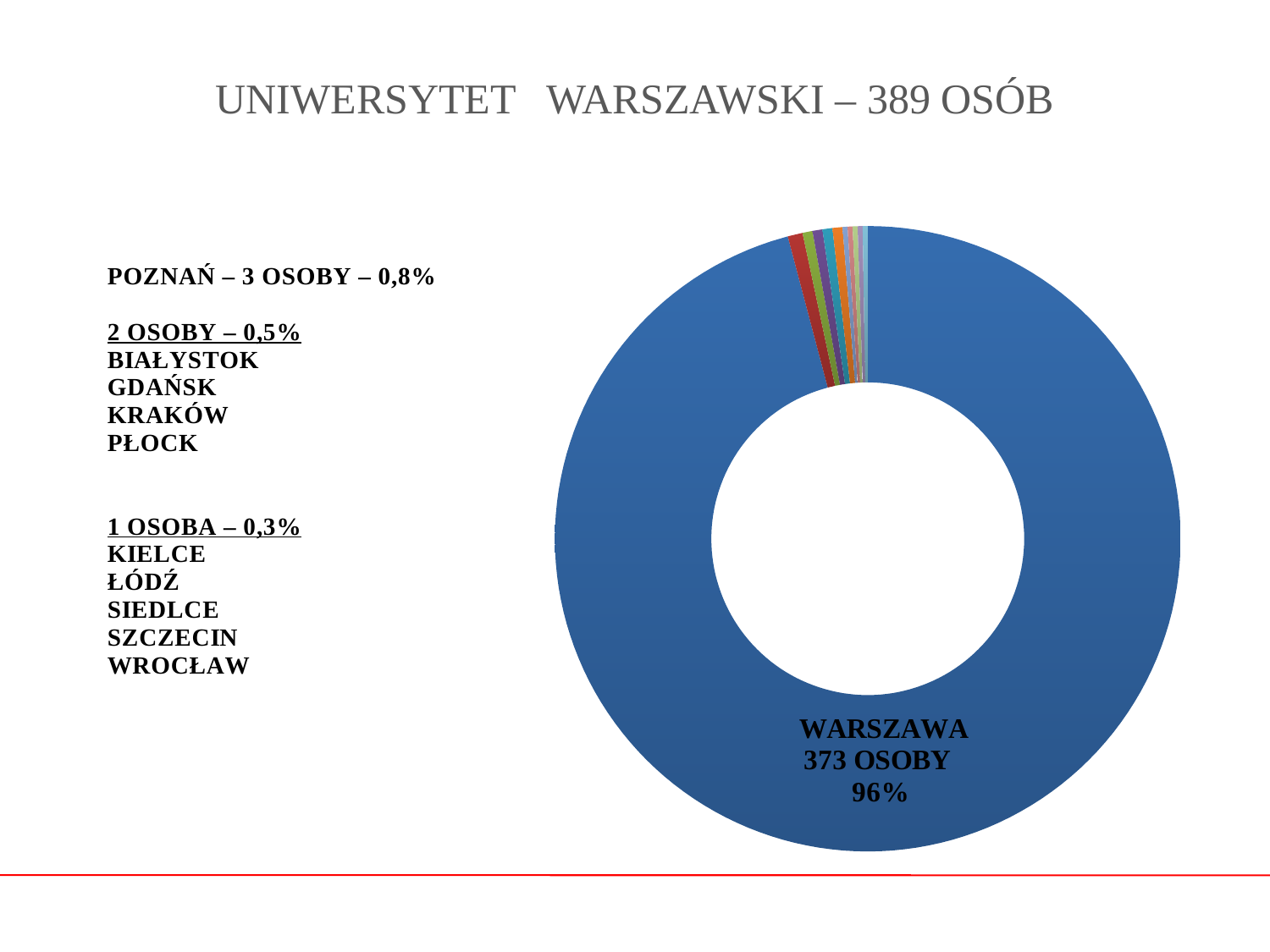
What percentage share is given for cities with 2 osoby (Białystok, Gdańsk, Kraków, Płock)? 0,5% What percentage share is given for Poznań? 0,8% Which is larger, the number of people from Poznań or from Kraków? Poznań What is the total number of people represented in the chart, as stated in the title? 389 osób What percentage share is given for cities with 1 osoba? 0,3% How many people does Poznań account for according to the slide? 3 osoby How many people does the Warszawa slice represent? 373 osoby What kind of chart is shown on the slide? Doughnut (pie) chart What is the difference in number of people between Warszawa and Poznań? 370 What is the title of the slide above the chart? UNIWERSYTET WARSZAWSKI – 389 OSÓB Which city has the largest slice in the chart? Warszawa